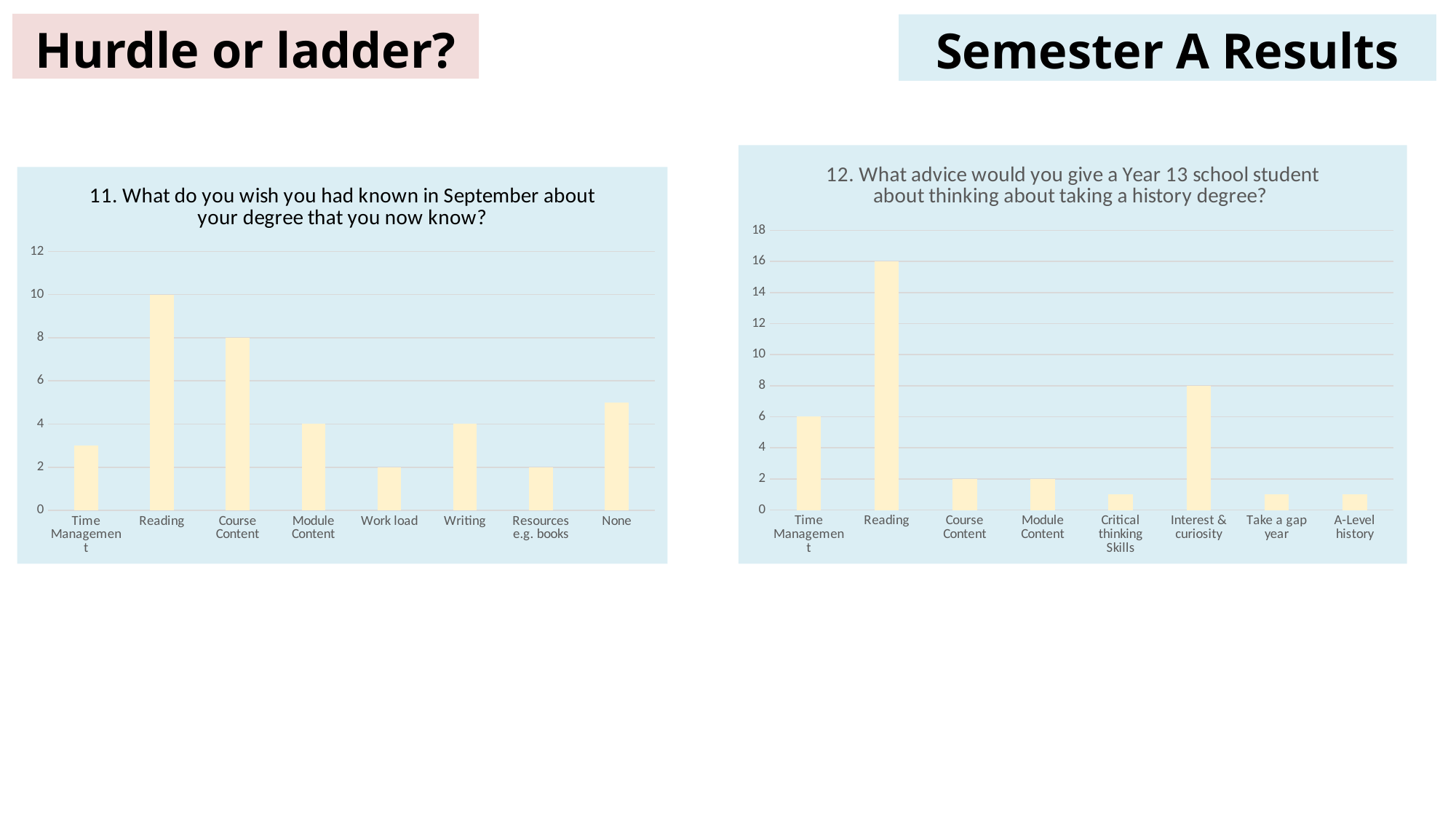
What kind of chart is the left chart (question 11)? Bar chart In the right chart (question 12), what is the difference between the values for Reading and Interest & curiosity? 8 In the right chart (question 12), is the value for Critical thinking Skills greater or less than 2? less In the right chart (question 12), which category has the highest value? Reading In the left chart (question 11), what is the difference between the values for Reading and Course Content? 2 In the left chart (question 11), is the value for None greater or less than 4? greater In the chart titled "11. What do you wish you had known in September about your degree that you now know?", what is the value for Course Content? 8 In the chart titled "11. What do you wish you had known in September about your degree that you now know?", what is the value for Reading? 10 In the chart titled "12. What advice would you give a Year 13 school student about thinking about taking a history degree?", what is the value for Interest & curiosity? 8 In the left chart (question 11), which category has the highest value? Reading In the chart titled "12. What advice would you give a Year 13 school student about thinking about taking a history degree?", what is the value for Reading? 16 How many categories are shown in the right chart (question 12)? 8